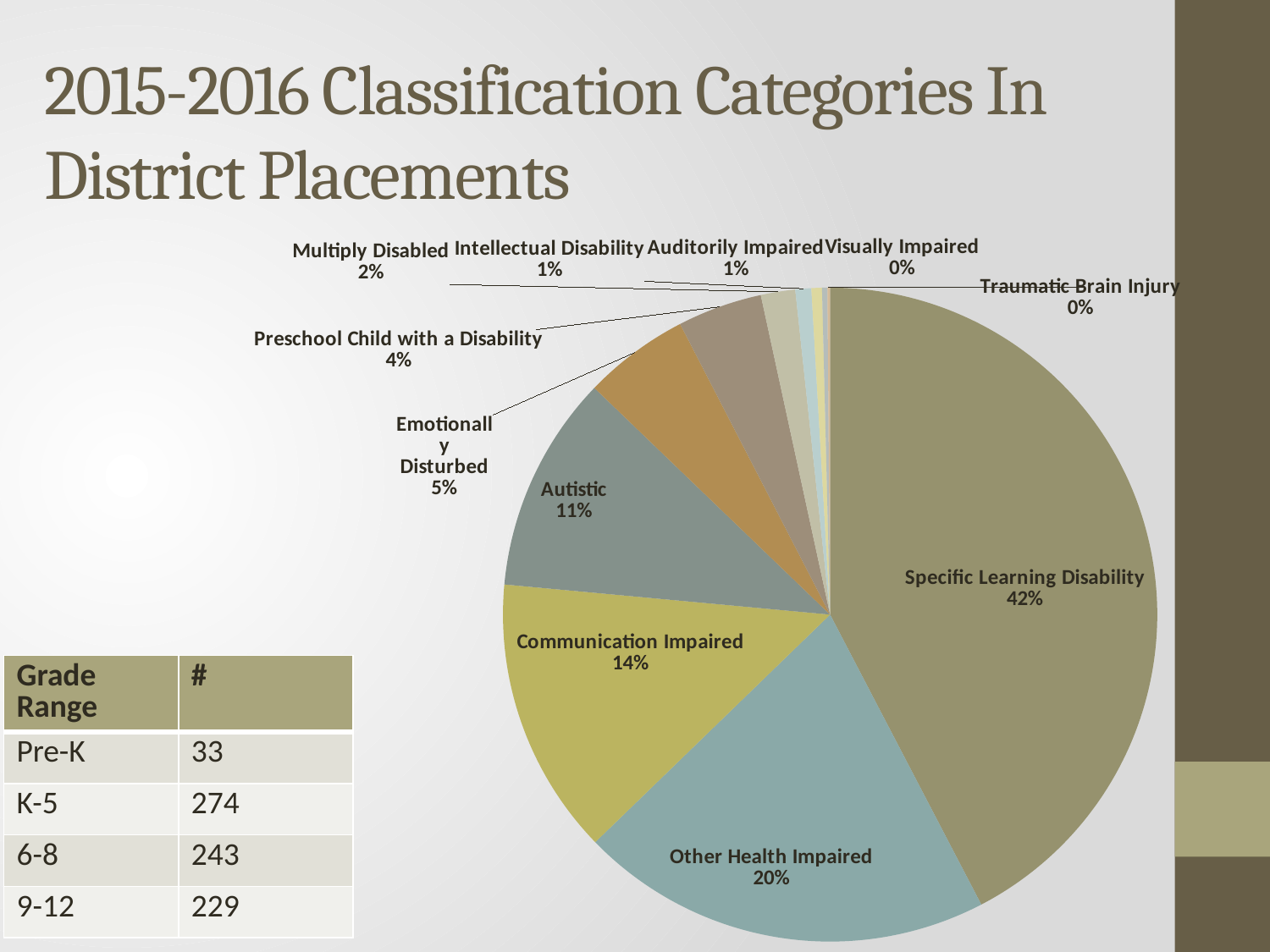
Which classification category has the largest share of the pie? Specific Learning Disability What percentage is shown for Emotionally Disturbed? 5% Which has a larger share, Communication Impaired or Autistic? Communication Impaired What share of the pie does Specific Learning Disability represent? 42% What percentage is shown for Other Health Impaired? 20% What percentage is shown for Preschool Child with a Disability? 4% How many classification categories are shown in the pie chart? 11 What type of chart is shown on the slide? pie chart What percentage is shown for Autistic? 11% What percentage is shown for Communication Impaired? 14% What is the difference in percentage points between Specific Learning Disability and Other Health Impaired? 22 What is the title of the slide containing the pie chart? 2015-2016 Classification Categories In District Placements